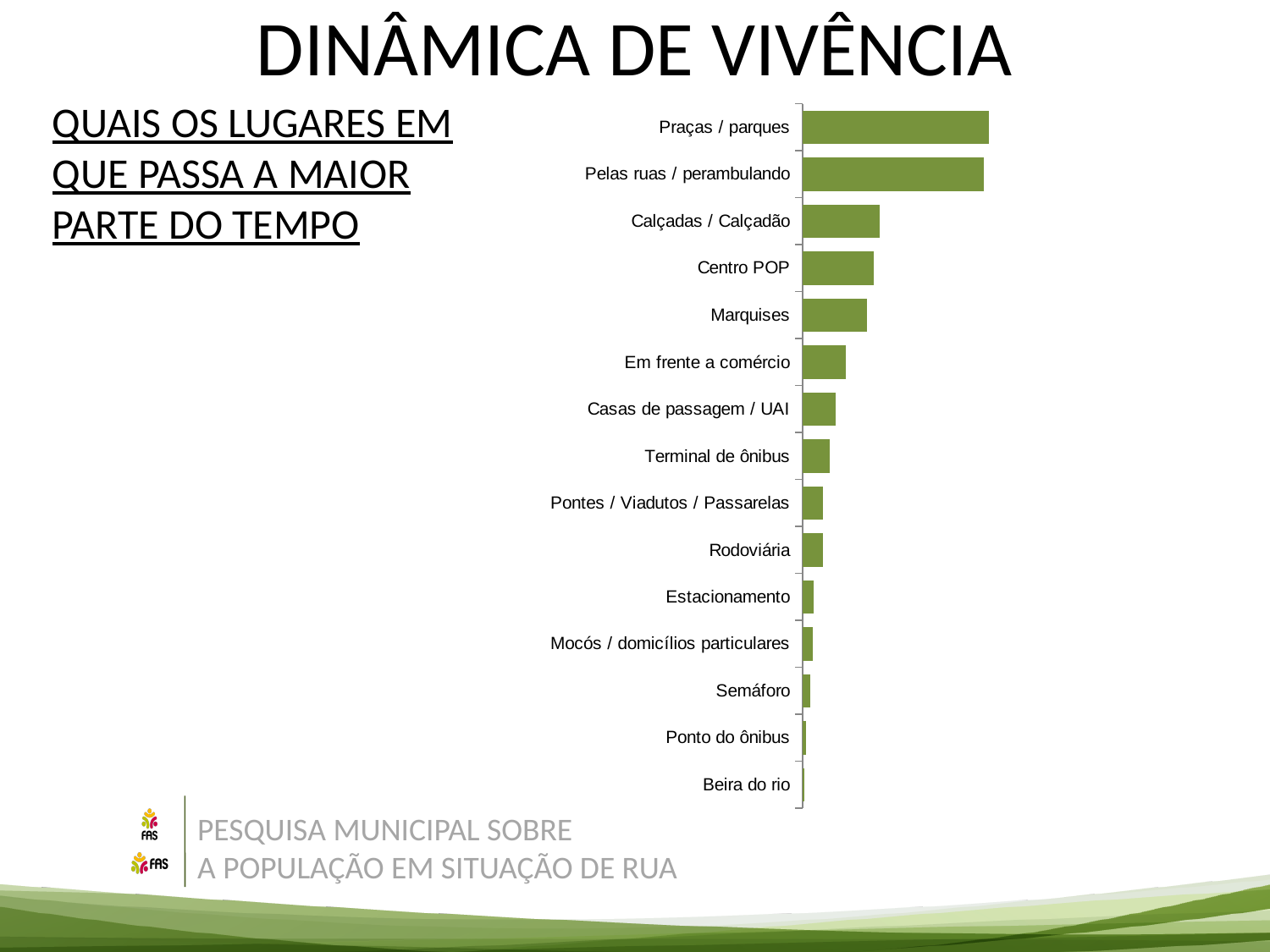
How many categories (places) are listed in the chart? 15 Which is larger, the value for Semáforo or the value for Ponto do ônibus? Semáforo What question does the chart answer, according to the underlined text on the left of the slide? Quais os lugares em que passa a maior parte do tempo Do the bar values rise or fall going from the top category to the bottom category? fall Which category has the lowest value in the chart? Beira do rio Which is larger, the value for Praças / parques or the value for Calçadas / Calçadão? Praças / parques Which is larger, the value for Centro POP or the value for Em frente a comércio? Centro POP What colour are the bars in the chart? green What kind of chart is shown on the slide? bar chart